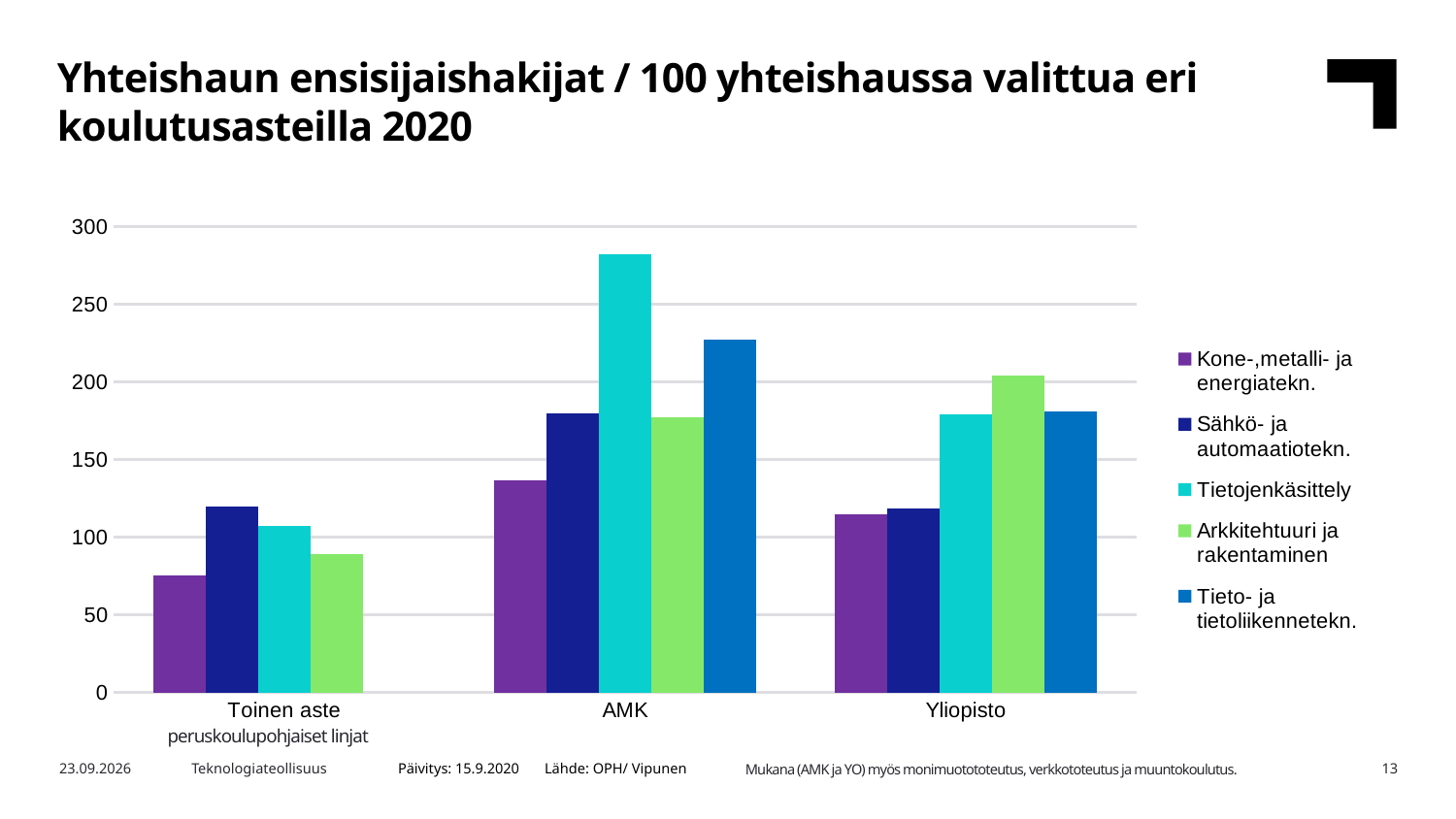
How many education-level categories are shown on the x axis? 3 Which series has the tallest bar in the whole chart, and in which category? Tietojenkäsittely, AMK Which legend series has no bar in the Toinen aste category? Tieto- ja tietoliikennetekn. Is the value for Tieto- ja tietoliikennetekn. in the AMK category greater or less than 200? greater What kind of chart is shown on the slide? bar chart How many series does the legend list? 5 Which series has the lowest value in the AMK category? Kone-,metalli- ja energiatekn. In the Toinen aste category, which is larger: Sähkö- ja automaatiotekn. or Tietojenkäsittely? Sähkö- ja automaatiotekn. For Arkkitehtuuri ja rakentaminen, which category has the larger value: AMK or Yliopisto? Yliopisto Is the value for Tietojenkäsittely in the AMK category greater or less than 250? greater Which series has the highest value in the Yliopisto category? Arkkitehtuuri ja rakentaminen Is the value for Kone-,metalli- ja energiatekn. in the Toinen aste category greater or less than 100? less